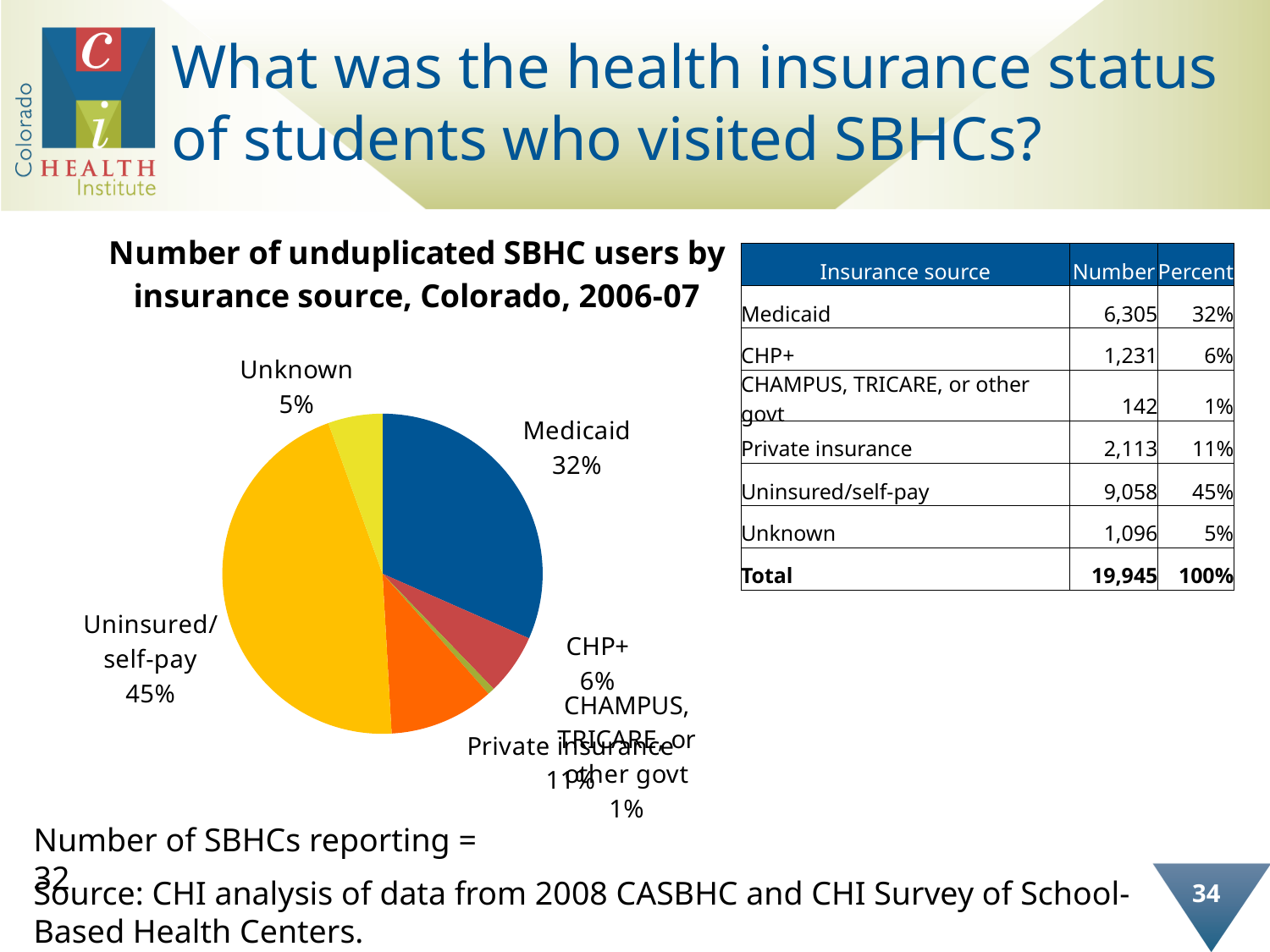
What share of the pie does Uninsured/self-pay represent? 45% What share of the pie does Private insurance represent? 11% What type of chart is shown on the slide? pie chart What share of the pie does Unknown represent? 5% Which insurance source has the largest slice of the pie? Uninsured/self-pay How many slices does the pie chart have? 6 What is the difference in percentage points between the Uninsured/self-pay slice and the Medicaid slice? 13 percentage points What is the title of the pie chart? Number of unduplicated SBHC users by insurance source, Colorado, 2006-07 Which insurance source has the smallest slice of the pie? CHAMPUS, TRICARE, or other govt Which is larger, the Private insurance slice or the CHP+ slice? Private insurance